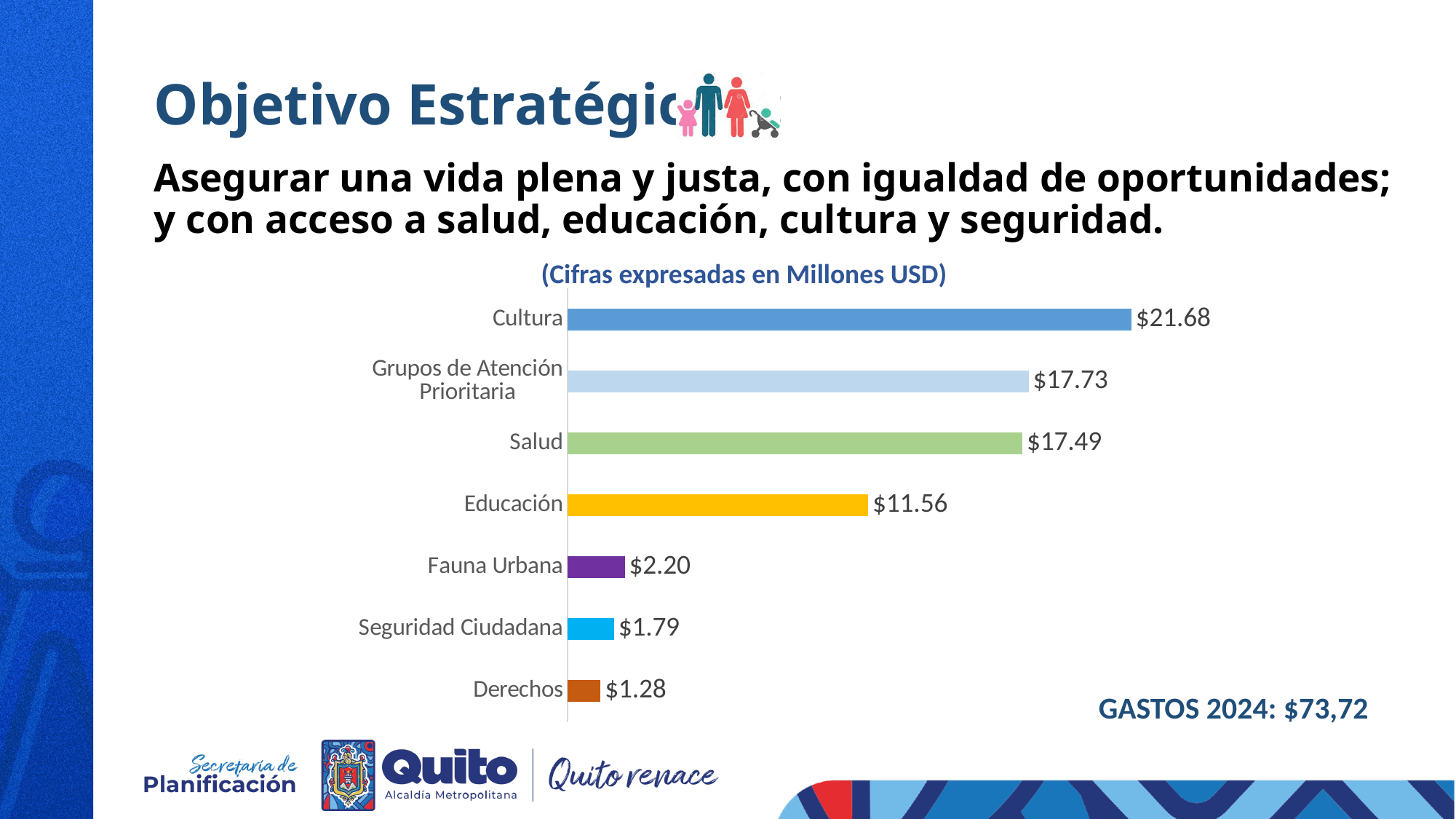
In what units does the chart say the figures are expressed? Millones USD What is the value for Educación? $11.56 What is the value for Salud? $17.49 Which category has the lowest value? Derechos What kind of chart is shown on the slide? Bar chart What is the difference between the values for Fauna Urbana and Seguridad Ciudadana? $0.41 How many categories are shown in the chart? 7 What is the value for Cultura? $21.68 What is the value for Seguridad Ciudadana? $1.79 Which category has the highest value? Cultura Which is larger, the value for Grupos de Atención Prioritaria or the value for Salud? Grupos de Atención Prioritaria What is the difference between the values for Cultura and Educación? $10.12